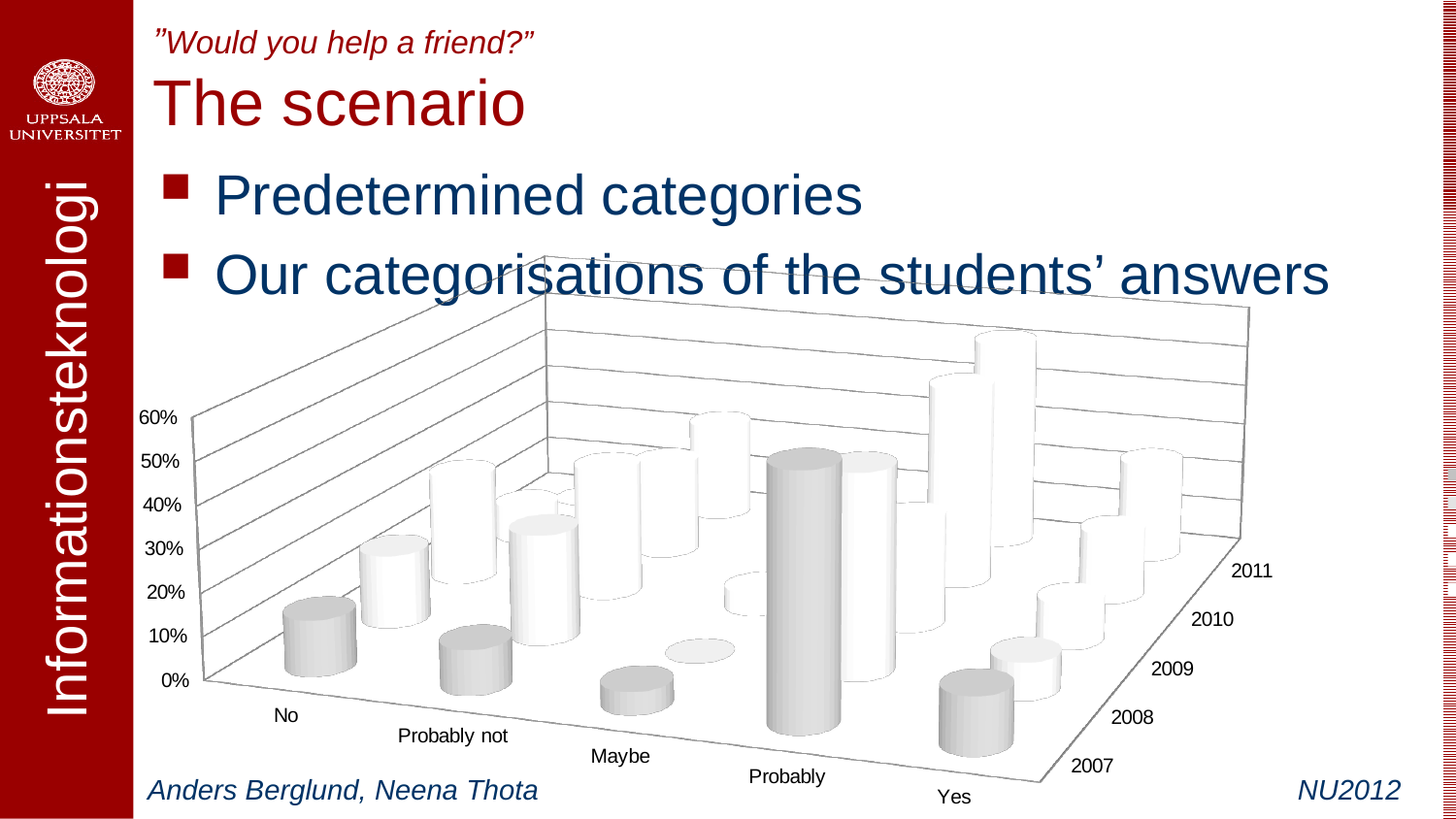
What kind of chart is shown on the slide? bar chart Is the 2007 value for No greater or less than 30%? less Is the 2007 value for Maybe greater or less than 10%? less Which year is listed first (at the front) on the depth axis of the chart? 2007 In the 2007 row, which is larger: the bar for Probably or the bar for Yes? Probably Which answer category has the shortest bar in the 2007 row? Maybe Which answer category has the tallest bar in the 2007 row? Probably In the 2007 row, which is larger: the bar for No or the bar for Maybe? No How many years are shown along the depth axis of the chart? 5 What is the highest value shown on the vertical axis of the chart? 60% Is the 2007 value for Probably greater or less than 30%? greater How many answer categories are shown along the front axis of the chart? 5